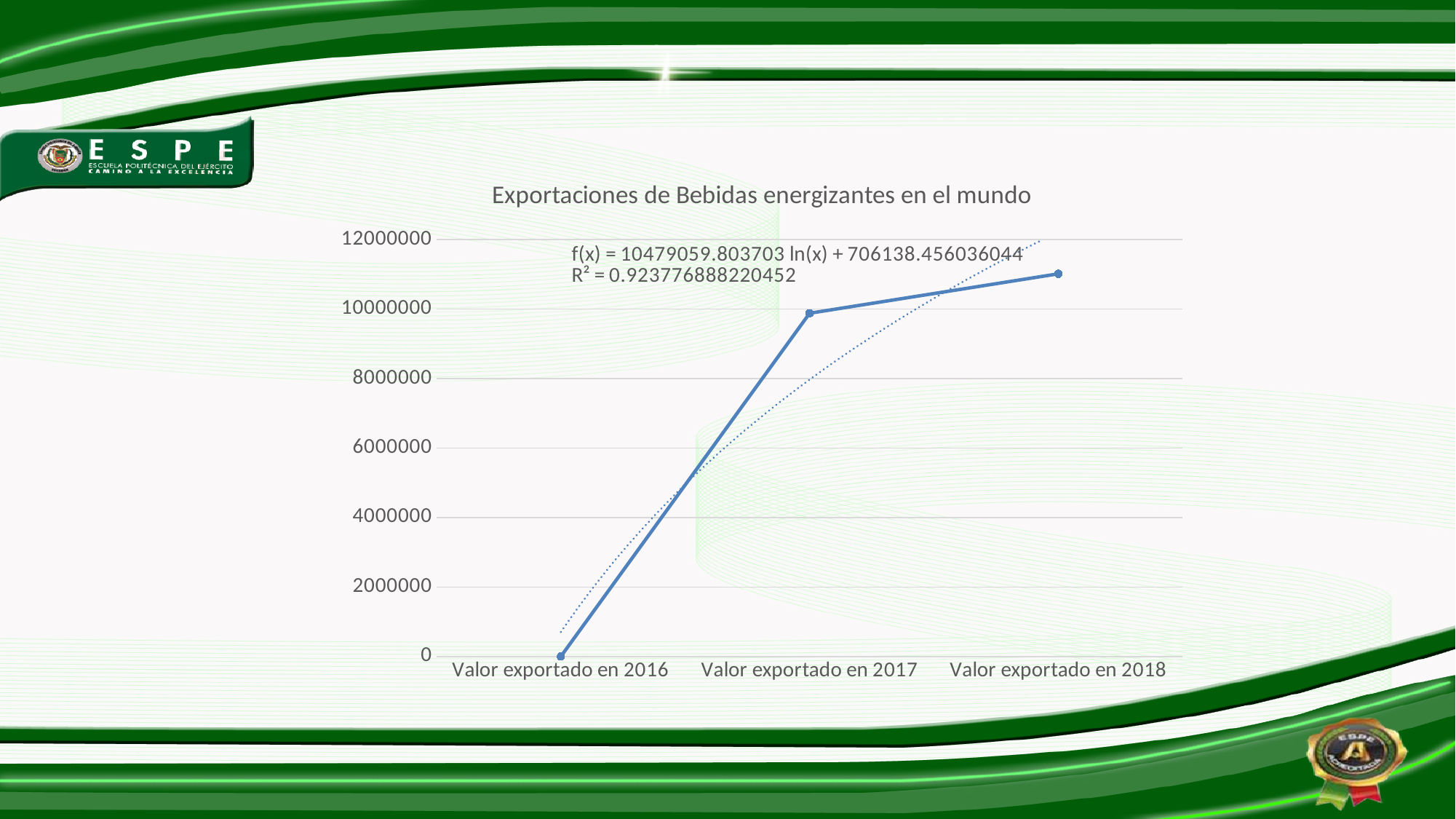
What R² value is shown for the trendline on the chart? 0.923776888220452 Do the values rise or fall from 2016 to 2018 along the x axis? rise Is the value for Valor exportado en 2018 greater or less than 10000000? greater Is the value for Valor exportado en 2017 greater or less than 8000000? greater How many data points are plotted on the chart? 3 Which category has the highest value? Valor exportado en 2018 Which is larger, the value for Valor exportado en 2017 or Valor exportado en 2018? Valor exportado en 2018 What kind of chart is shown on the slide? line chart What is the title of the chart? Exportaciones de Bebidas energizantes en el mundo Which category has the lowest value? Valor exportado en 2016